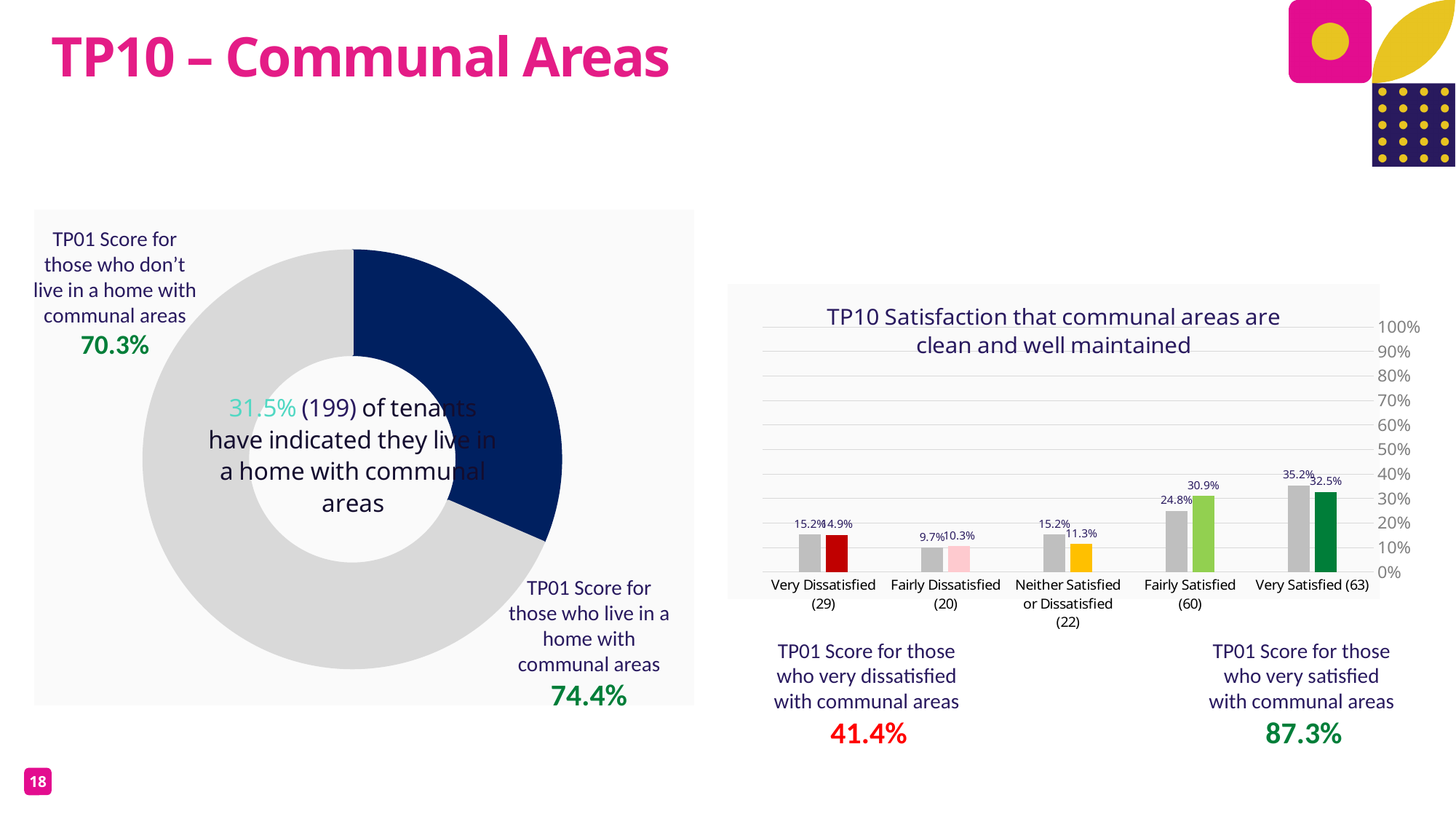
In the 'TP10 Satisfaction that communal areas are clean and well maintained' chart, what is the value of the coloured (yellow) bar for Neither Satisfied or Dissatisfied? 11.3% In the donut chart on the left, what share of tenants have indicated they live in a home with communal areas? 31.5% In the 'TP10 Satisfaction that communal areas are clean and well maintained' chart, is the grey bar for Very Satisfied greater or less than 30%? greater In the 'TP10 Satisfaction that communal areas are clean and well maintained' chart, how many categories are shown on the x axis? 5 What type of chart is the chart on the left of the slide? pie chart (donut) In the 'TP10 Satisfaction that communal areas are clean and well maintained' chart, what is the value of the coloured (green) bar for Very Satisfied? 32.5% What type of chart is the chart on the right of the slide? bar chart In the 'TP10 Satisfaction that communal areas are clean and well maintained' chart, what is the difference between the coloured bar and the grey bar for Fairly Satisfied? 6.1% In the 'TP10 Satisfaction that communal areas are clean and well maintained' chart, which is larger for Very Dissatisfied: the grey bar or the red bar? the grey bar In the 'TP10 Satisfaction that communal areas are clean and well maintained' chart, what is the value of the grey bar for Fairly Satisfied? 24.8% In the 'TP10 Satisfaction that communal areas are clean and well maintained' chart, which category has the lowest grey bar? Fairly Dissatisfied In the 'TP10 Satisfaction that communal areas are clean and well maintained' chart, which category has the highest grey bar? Very Satisfied